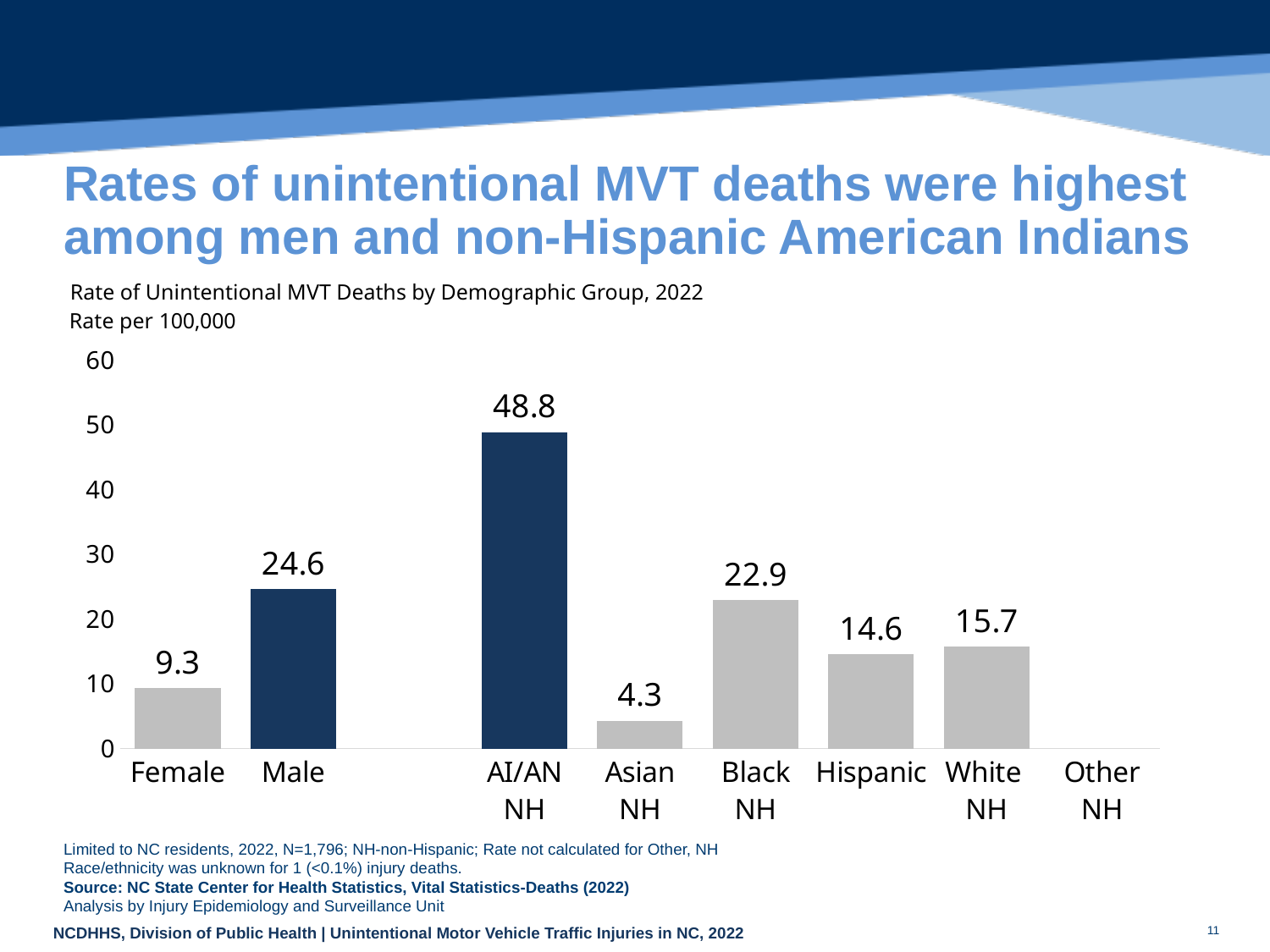
What is the unit of the rate shown on the chart? Rate per 100,000 What is the rate of unintentional MVT deaths for Hispanic? 14.6 How many demographic groups are labelled on the x axis of the chart? 8 What is the difference between the Black NH and White NH rates? 7.2 Which has a higher rate of unintentional MVT deaths, White NH or Hispanic? White NH Which demographic group with a plotted value has the lowest rate of unintentional MVT deaths? Asian NH Is the rate for Black NH greater or less than 20? greater What is the rate of unintentional MVT deaths for AI/AN NH? 48.8 What is the difference between the Male and Female rates of unintentional MVT deaths? 15.3 What kind of chart is shown on the slide? Bar chart What is the rate of unintentional MVT deaths for Male? 24.6 Which demographic group has the highest rate of unintentional MVT deaths? AI/AN NH